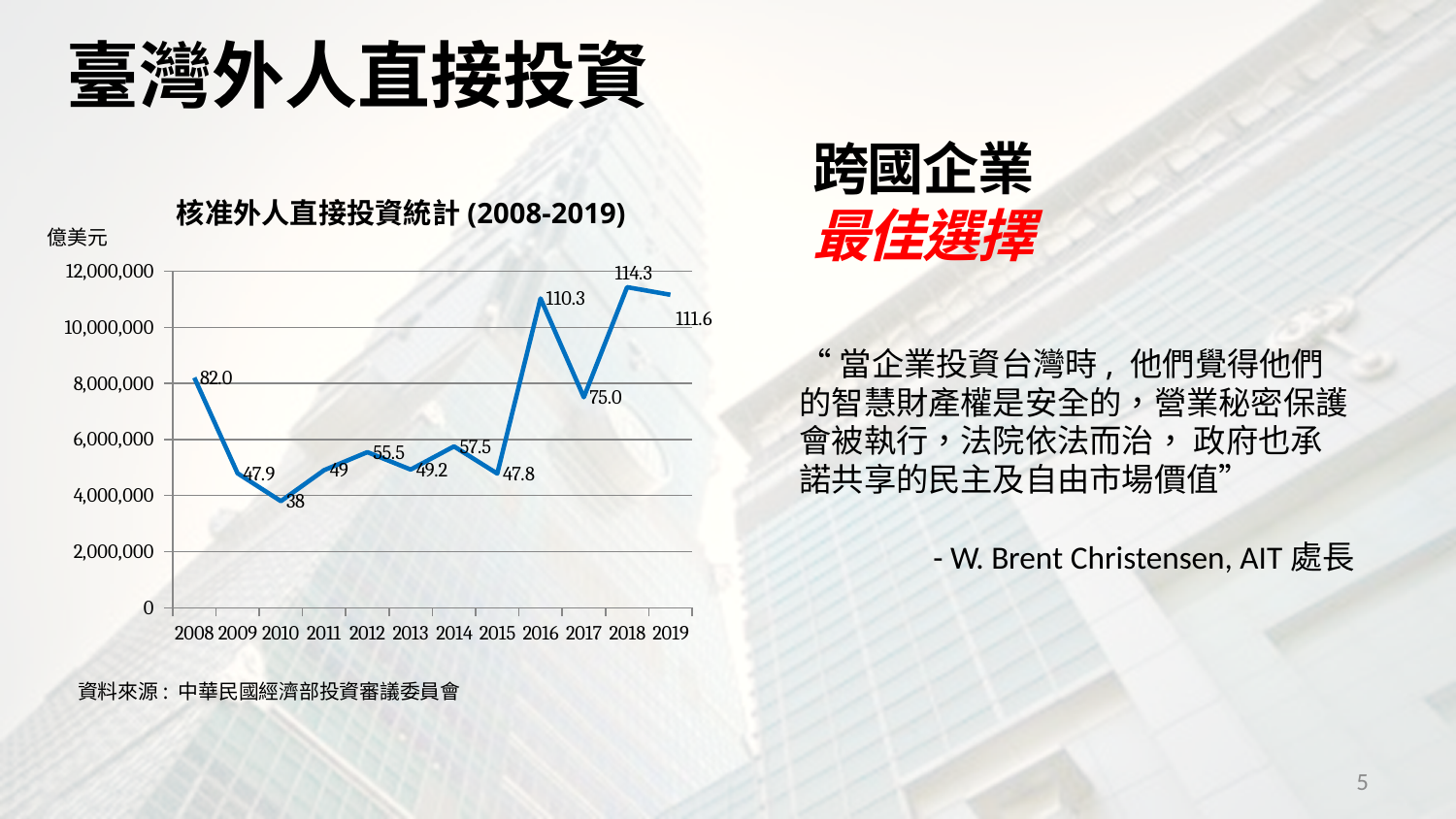
What is the value for 2019 in the chart? 111.6 Which is larger, the value for 2012 or the value for 2014? 2014 Which year has the highest value in the chart? 2018 Is the value for 2015 greater or less than 6,000,000 on the axis? less What is the value for 2008 in the chart? 82.0 What is the title of the chart? 核准外人直接投資統計 (2008-2019) What is the difference between the values for 2018 and 2017? 39.3 Does the value rise or fall from 2008 to 2010? fall What type of chart is shown on the slide? line chart How many years are plotted on the x axis of the chart? 12 Which year has the lowest value in the chart? 2010 What is the value for 2016 in the chart? 110.3